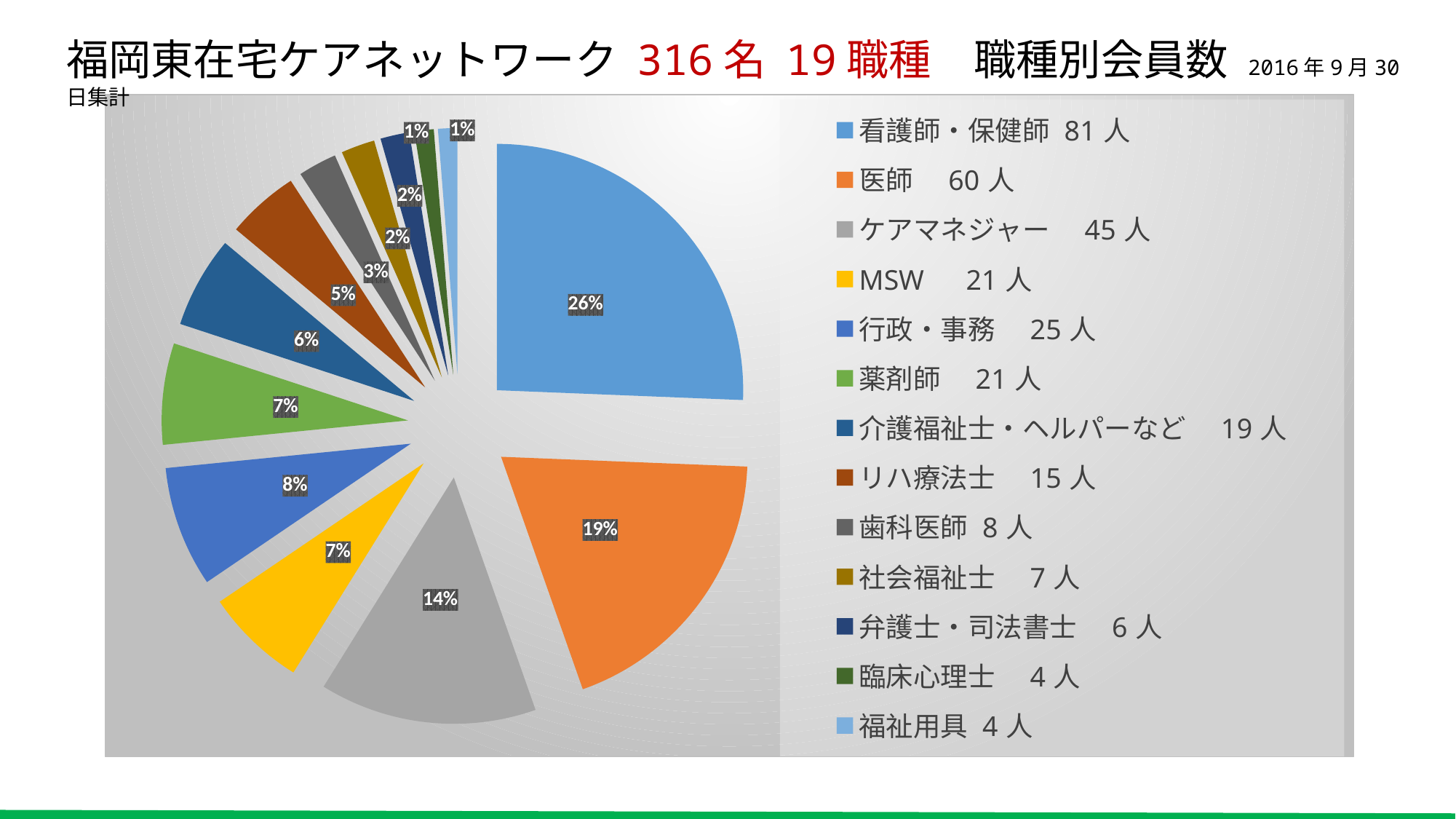
What share of the pie does 医師 represent? 19% What share of the pie does 看護師・保健師 represent? 26% What share of the pie does ケアマネジャー represent? 14% How many slices does the pie chart have? 13 According to the legend, how many members are in the 薬剤師 category? 21人 What kind of chart is shown on the slide? pie chart What colour is the 医師 slice in the pie chart? orange What is the difference in percentage points between the 看護師・保健師 slice and the 医師 slice? 7 percentage points Which slice is larger, 医師 or ケアマネジャー? 医師 Which category has the largest slice of the pie? 看護師・保健師